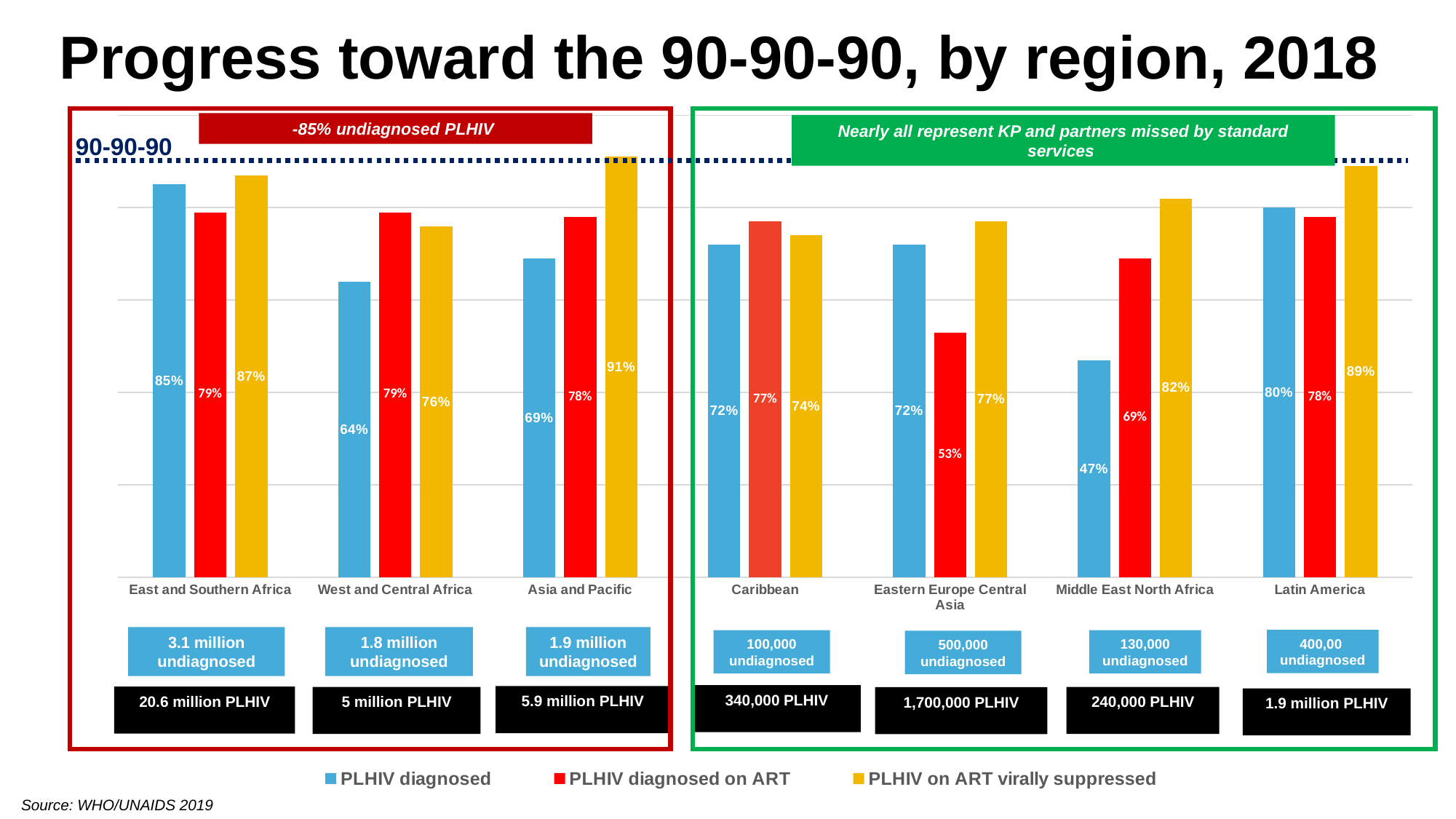
Which is larger: PLHIV diagnosed on ART in the Caribbean or in Middle East North Africa? Caribbean Which region has the highest value for PLHIV on ART virally suppressed? Asia and Pacific What is the difference between PLHIV diagnosed in East and Southern Africa and in West and Central Africa? 21% What is the value for PLHIV on ART virally suppressed in Asia and Pacific? 91% What is the value for PLHIV on ART virally suppressed in Latin America? 89% Which colour represents PLHIV on ART virally suppressed in the legend? Yellow What kind of chart is shown on the slide? Bar chart Which region has the lowest value for PLHIV diagnosed? Middle East North Africa How many series does the legend list? 3 How many regions are shown on the x axis of the chart? 7 What is the value for PLHIV diagnosed on ART in Eastern Europe Central Asia? 53% What is the value for PLHIV diagnosed in East and Southern Africa? 85%